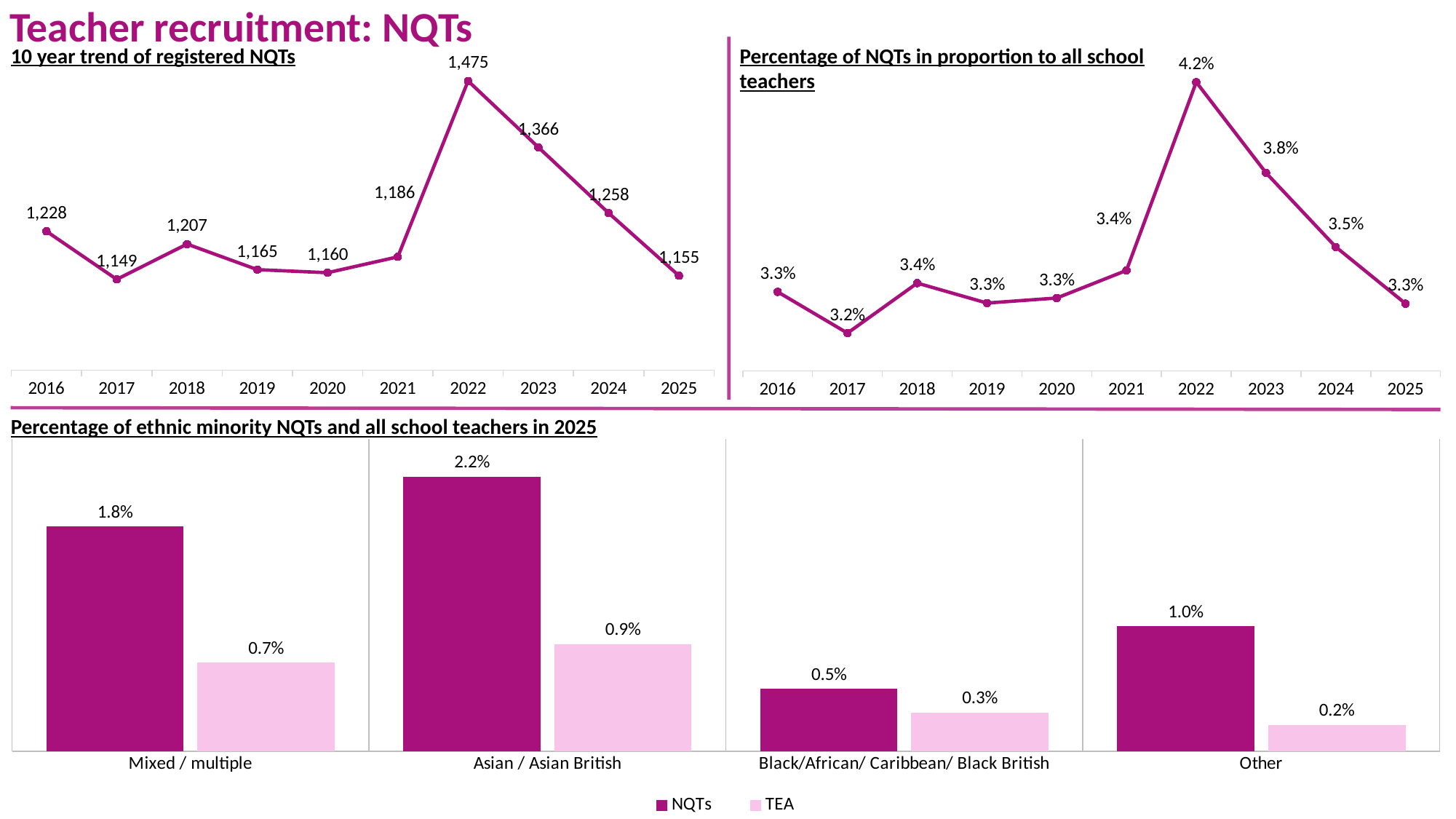
What kind of chart is the 'Percentage of ethnic minority NQTs and all school teachers in 2025' chart? bar chart How many series does the legend of the 'Percentage of ethnic minority NQTs and all school teachers in 2025' chart list? 2 In the 'Percentage of ethnic minority NQTs and all school teachers in 2025' chart, which category has the lowest TEA value? Other In the 'Percentage of NQTs in proportion to all school teachers' chart, do values rise or fall from 2022 to 2025? fall In the 'Percentage of ethnic minority NQTs and all school teachers in 2025' chart, what is the NQTs value for Asian / Asian British? 2.2% In the '10 year trend of registered NQTs' chart, what is the value for 2022? 1,475 In the '10 year trend of registered NQTs' chart, how many years are plotted? 10 In the '10 year trend of registered NQTs' chart, what is the difference between the 2022 and 2025 values? 320 In the 'Percentage of NQTs in proportion to all school teachers' chart, what is the value for 2023? 3.8% In the 'Percentage of NQTs in proportion to all school teachers' chart, which year has the highest value? 2022 In the '10 year trend of registered NQTs' chart, which year has the lowest value? 2017 In the 'Percentage of ethnic minority NQTs and all school teachers in 2025' chart, what is the difference between the NQTs and TEA values for Mixed / multiple? 1.1%